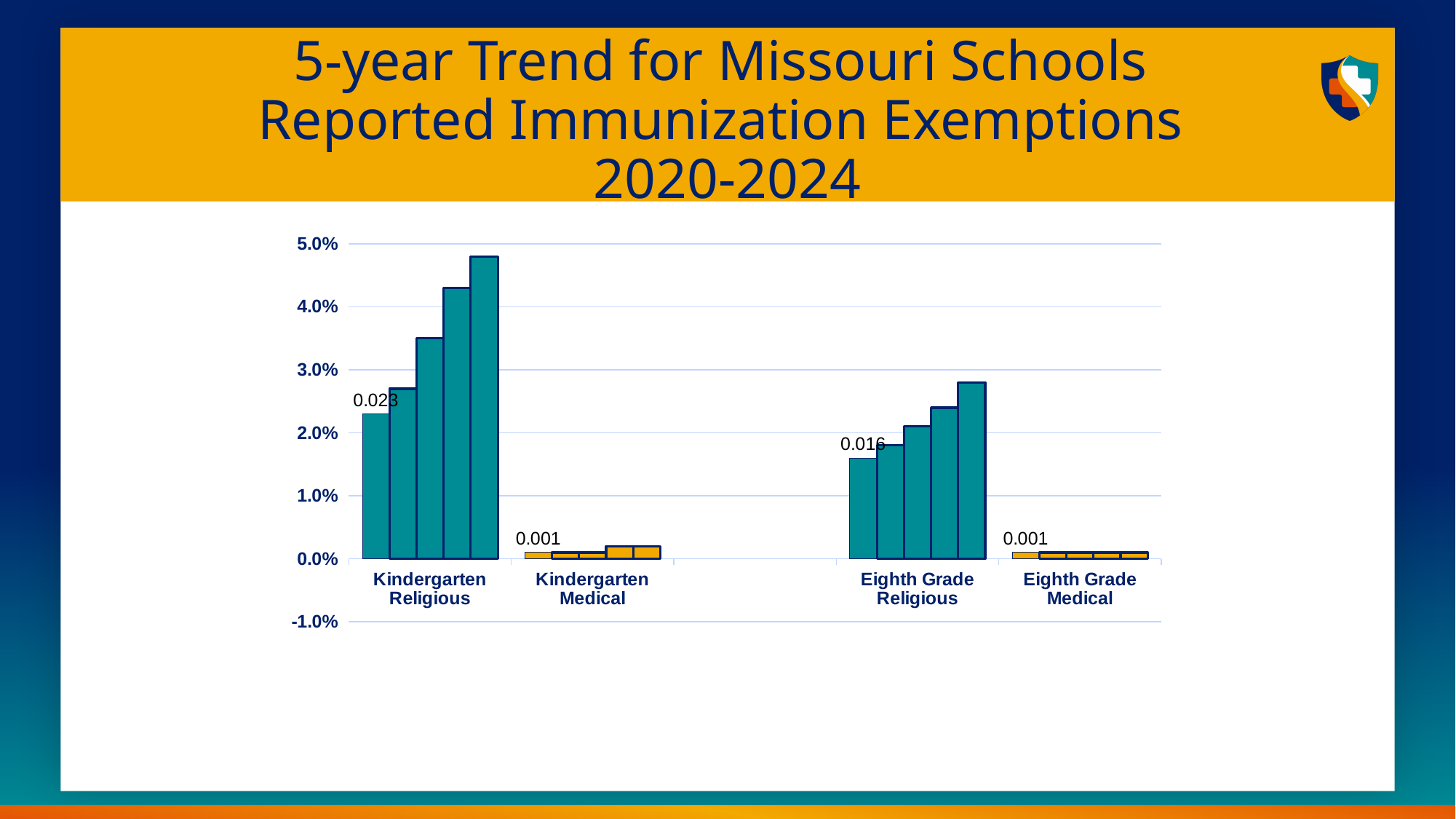
What is the difference between the labelled first bar of Kindergarten Religious (0.023) and the labelled first bar of Eighth Grade Religious (0.016)? 0.007 Is the tallest bar in the Kindergarten Religious group greater or less than 4.0%? greater Which is larger, the labelled first bar of Kindergarten Religious or the labelled first bar of Eighth Grade Religious? Kindergarten Religious Is the tallest bar in the Eighth Grade Religious group greater or less than 2.0%? greater Which category group contains the tallest bar in the chart? Kindergarten Religious How many category groups are shown along the x axis of the chart? 4 Within the Kindergarten Religious group, do the bars rise or fall from left to right? rise What value is printed on the first bar of the Eighth Grade Medical group? 0.001 What value is printed on the first bar of the Kindergarten Medical group? 0.001 What value is printed on the first bar of the Kindergarten Religious group? 0.023 What kind of chart is shown on the slide? bar chart What value is printed on the first bar of the Eighth Grade Religious group? 0.016